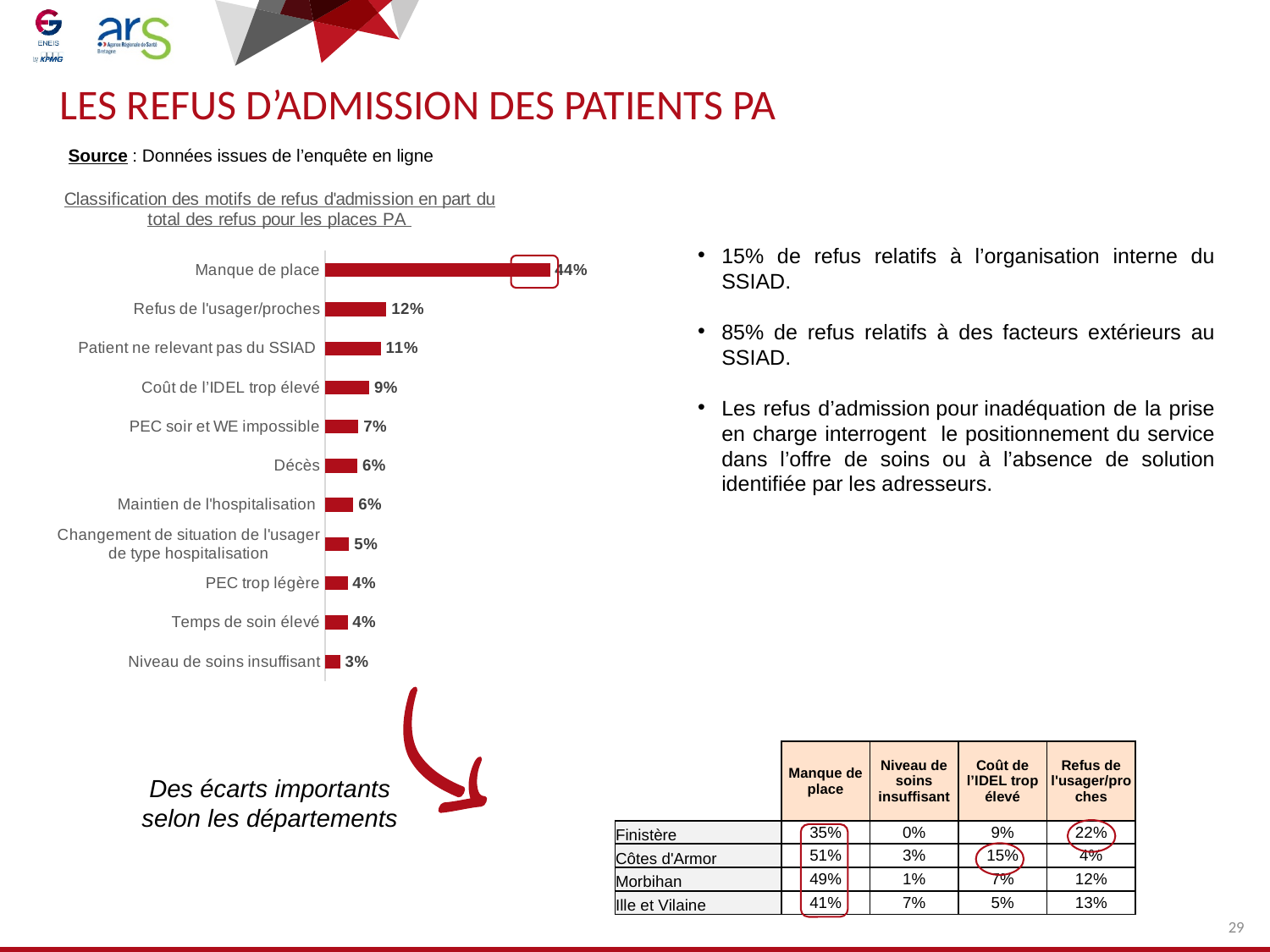
What is the value for "Manque de place"? 44% What is the difference between the values for "Décès" and "Niveau de soins insuffisant"? 3% Which category has the highest value? Manque de place What is the value for "Refus de l'usager/proches"? 12% How many categories are shown in the bar chart? 11 What is the value for "Coût de l'IDEL trop élevé"? 9% What is the difference between the values for "Manque de place" and "Refus de l'usager/proches"? 32% What is the value for "PEC soir et WE impossible"? 7% What type of chart is shown on the slide? Bar chart What is the title of the bar chart? Classification des motifs de refus d'admission en part du total des refus pour les places PA Which is larger, the value for "Patient ne relevant pas du SSIAD" or the value for "Coût de l'IDEL trop élevé"? Patient ne relevant pas du SSIAD Which category has the lowest value? Niveau de soins insuffisant